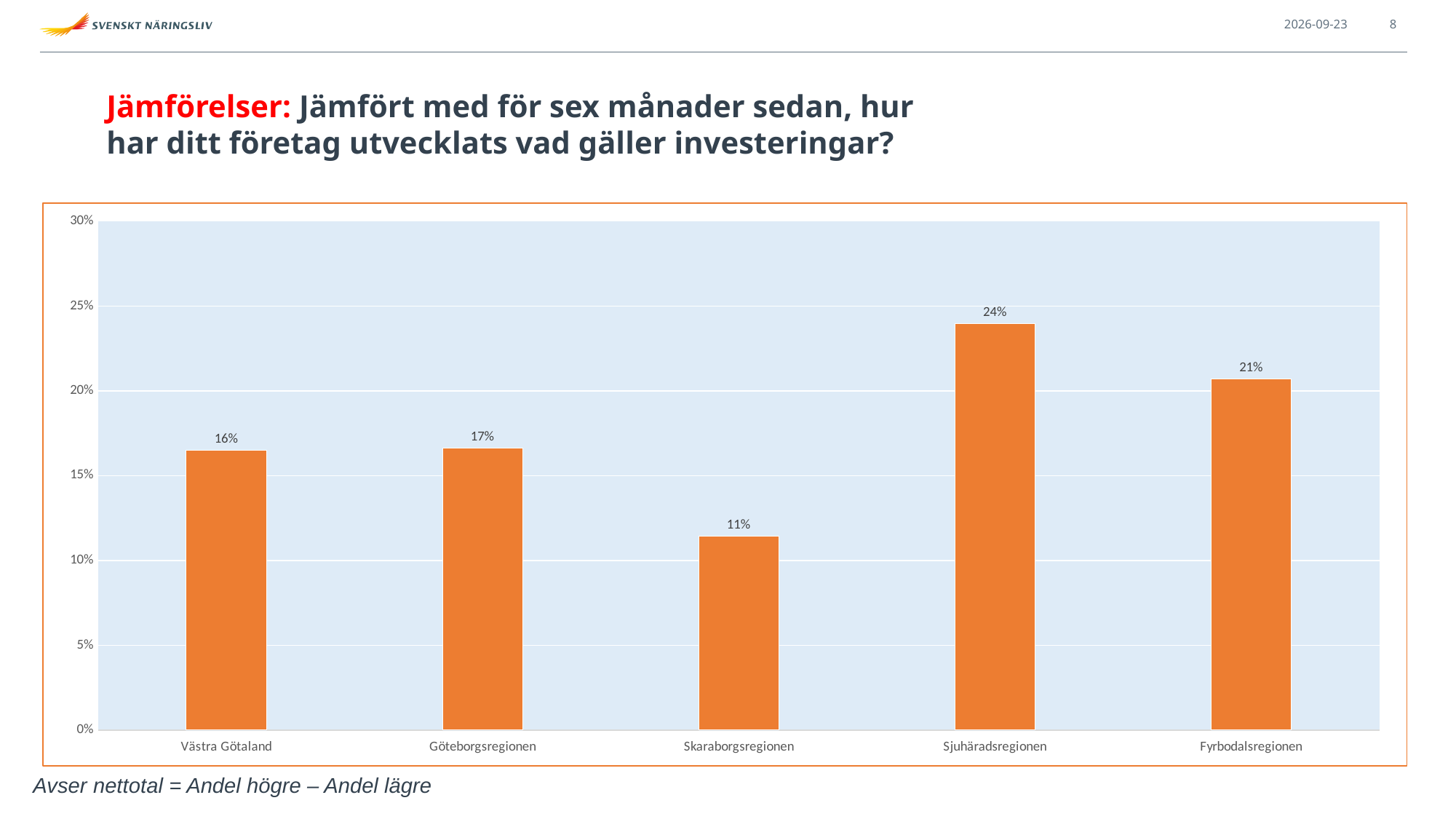
Which region has the highest value? Sjuhäradsregionen How many regions are shown on the x axis? 5 What is the value for Sjuhäradsregionen? 24% What is the highest value shown on the y axis? 30% Which region has the lowest value? Skaraborgsregionen Is the value for Fyrbodalsregionen greater or less than 20%? greater What is the difference between the values for Sjuhäradsregionen and Skaraborgsregionen? 13 percentage points What is the value for Fyrbodalsregionen? 21% What is the value for Västra Götaland? 16% What is the value for Skaraborgsregionen? 11% Which is larger, the value for Fyrbodalsregionen or the value for Göteborgsregionen? Fyrbodalsregionen What kind of chart is shown on the slide? Bar chart